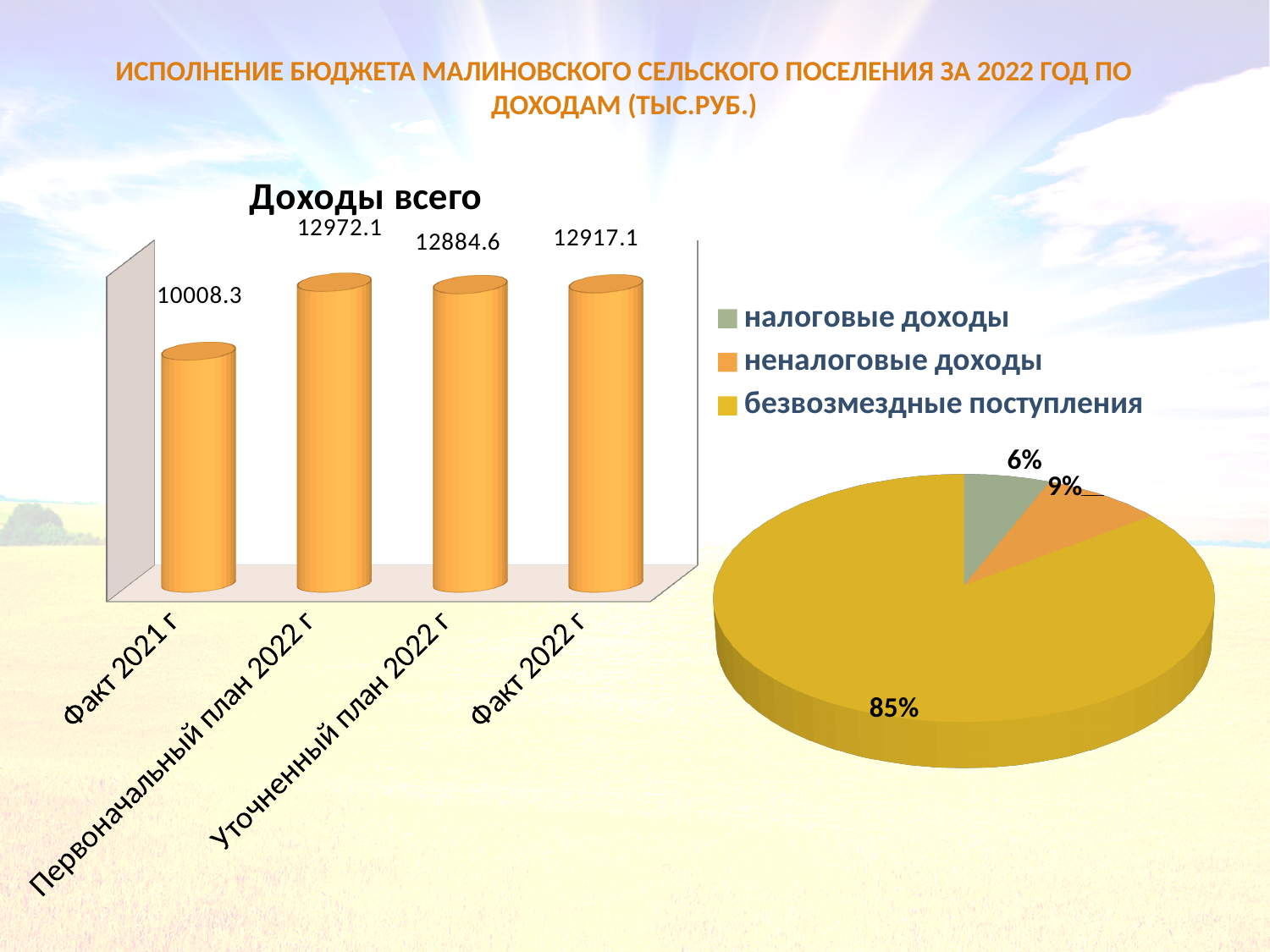
In the 'Доходы всего' bar chart, which category has the lowest value? Факт 2021 г In the 'Доходы всего' bar chart, which is larger: 'Уточненный план 2022 г' or 'Факт 2022 г'? Факт 2022 г In the 'Доходы всего' bar chart, what is the value for 'Факт 2022 г'? 12917.1 In the pie chart on the right, what share is 'налоговые доходы'? 6% How many categories are shown in the 'Доходы всего' bar chart? 4 In the 'Доходы всего' bar chart, what is the value for 'Первоначальный план 2022 г'? 12972.1 In the 'Доходы всего' bar chart, which category has the highest value? Первоначальный план 2022 г In the pie chart on the right, what share is 'безвозмездные поступления'? 85% In the 'Доходы всего' bar chart, what is the value for 'Факт 2021 г'? 10008.3 How many entries does the legend of the pie chart on the right list? 3 What kind of chart is the 'Доходы всего' chart on the left? Bar chart In the 'Доходы всего' bar chart, what is the difference between 'Факт 2022 г' and 'Факт 2021 г'? 2908.8